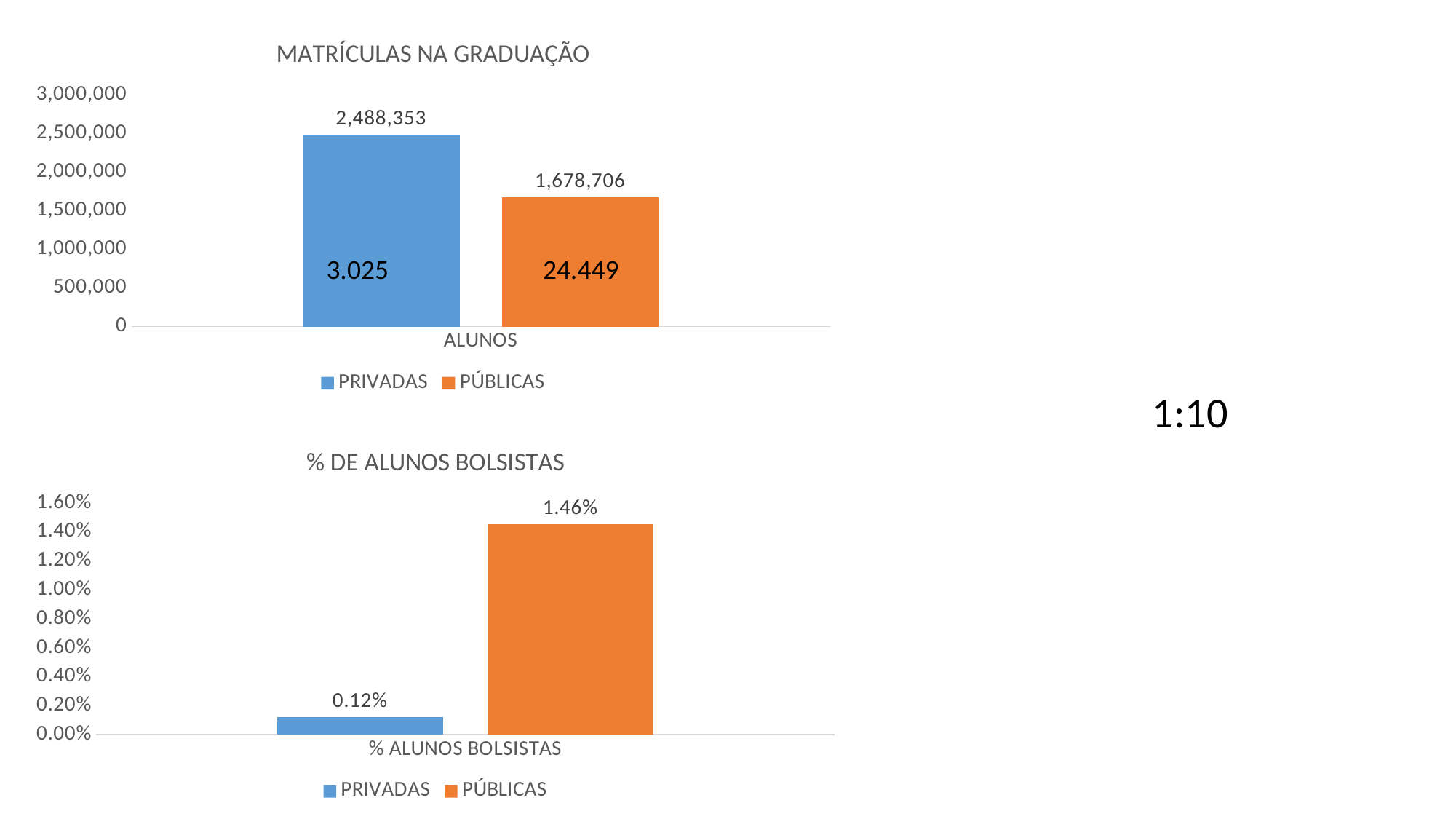
In the '% DE ALUNOS BOLSISTAS' chart, what is the value for PRIVADAS? 0.12% In the '% DE ALUNOS BOLSISTAS' chart, what is the category label on the x axis? % ALUNOS BOLSISTAS In the 'MATRÍCULAS NA GRADUAÇÃO' chart, how many series does the legend list? 2 In the 'MATRÍCULAS NA GRADUAÇÃO' chart, what is the difference between the PRIVADAS and PÚBLICAS values? 809,647 In the 'MATRÍCULAS NA GRADUAÇÃO' chart, what is the value for PÚBLICAS? 1,678,706 What kind of chart is the '% DE ALUNOS BOLSISTAS' chart? Bar chart In the '% DE ALUNOS BOLSISTAS' chart, which series has the lower value? PRIVADAS In the 'MATRÍCULAS NA GRADUAÇÃO' chart, what is the value for PRIVADAS? 2,488,353 In the 'MATRÍCULAS NA GRADUAÇÃO' chart, what text is printed inside the PÚBLICAS bar? 24.449 In the '% DE ALUNOS BOLSISTAS' chart, what is the value for PÚBLICAS? 1.46% In the 'MATRÍCULAS NA GRADUAÇÃO' chart, which series has the higher value? PRIVADAS In the '% DE ALUNOS BOLSISTAS' chart, what is the difference between the PÚBLICAS and PRIVADAS values? 1.34%